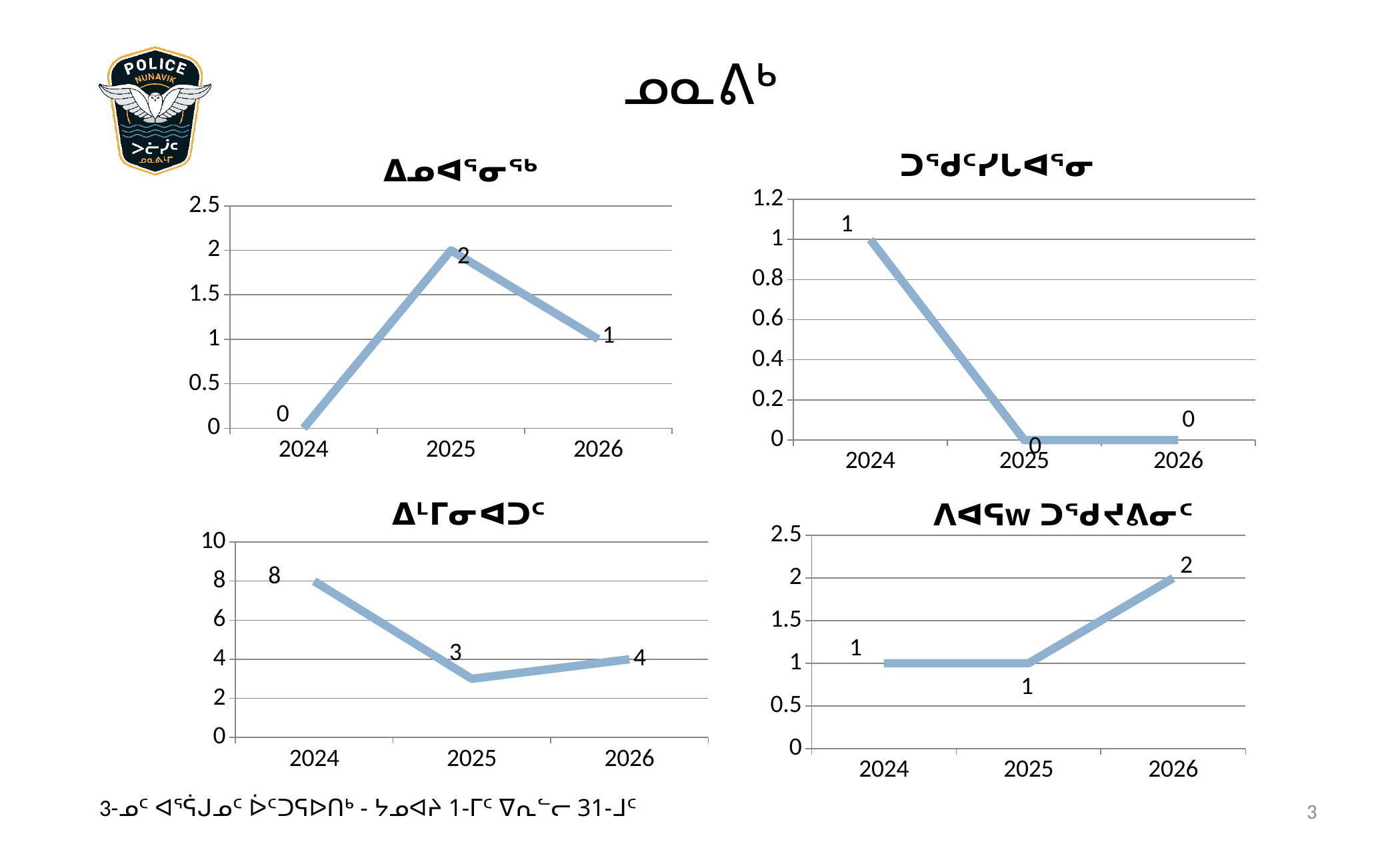
In the bottom-right chart, which is larger, the value for 2025 or the value for 2026? 2026 In the top-left chart, which year has the highest value? 2025 In the bottom-left chart, what is the value for 2024? 8 How many charts are shown on the slide? 4 In the bottom-right chart, what is the value for 2026? 2 In the bottom-left chart, what is the difference between the values for 2024 and 2025? 5 In the bottom-left chart, which year has the lowest value? 2025 How many data points are plotted in the bottom-right chart? 3 In the top-right chart, do the values rise or fall from 2024 to 2025? fall What type of chart is the top-left chart? line chart In the top-right chart, what is the value for 2024? 1 In the top-left chart, what is the value for 2025? 2